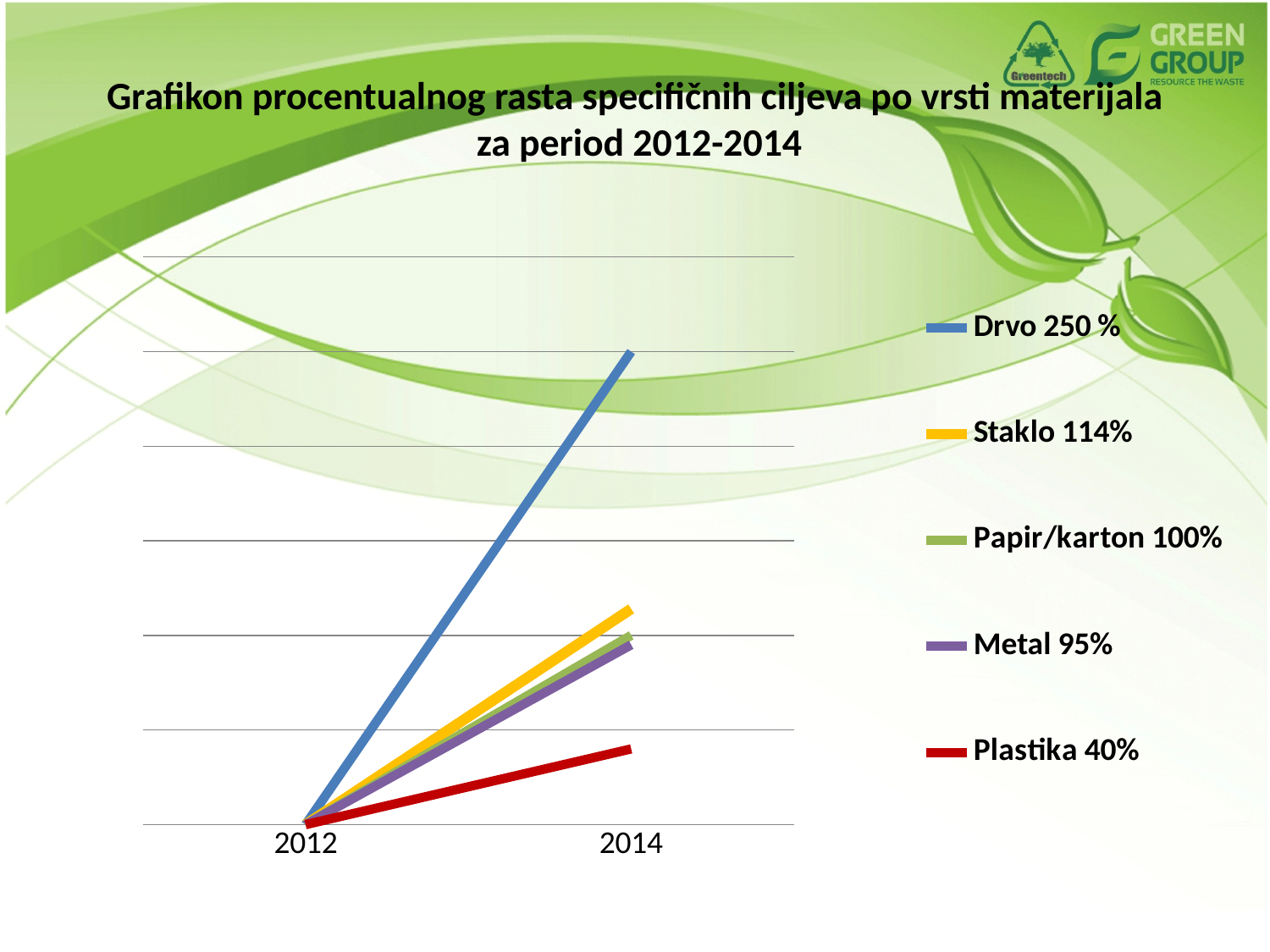
How many points are shown on the x axis? 2 According to the legend, what growth percentage is given for Metal? 95% What are the two years labelled on the x axis? 2012 and 2014 Which series is higher in 2014, Metal or Plastika? Metal According to the legend, what growth percentage is given for Plastika? 40% Which series has the lowest value in 2014? Plastika What kind of chart is shown on the slide? line chart Do the lines rise or fall from 2012 to 2014? rise How many series does the legend list? 5 Which series is higher in 2014, Drvo or Staklo? Drvo Which series has the highest value in 2014? Drvo According to the legend, what growth percentage is given for Staklo? 114%